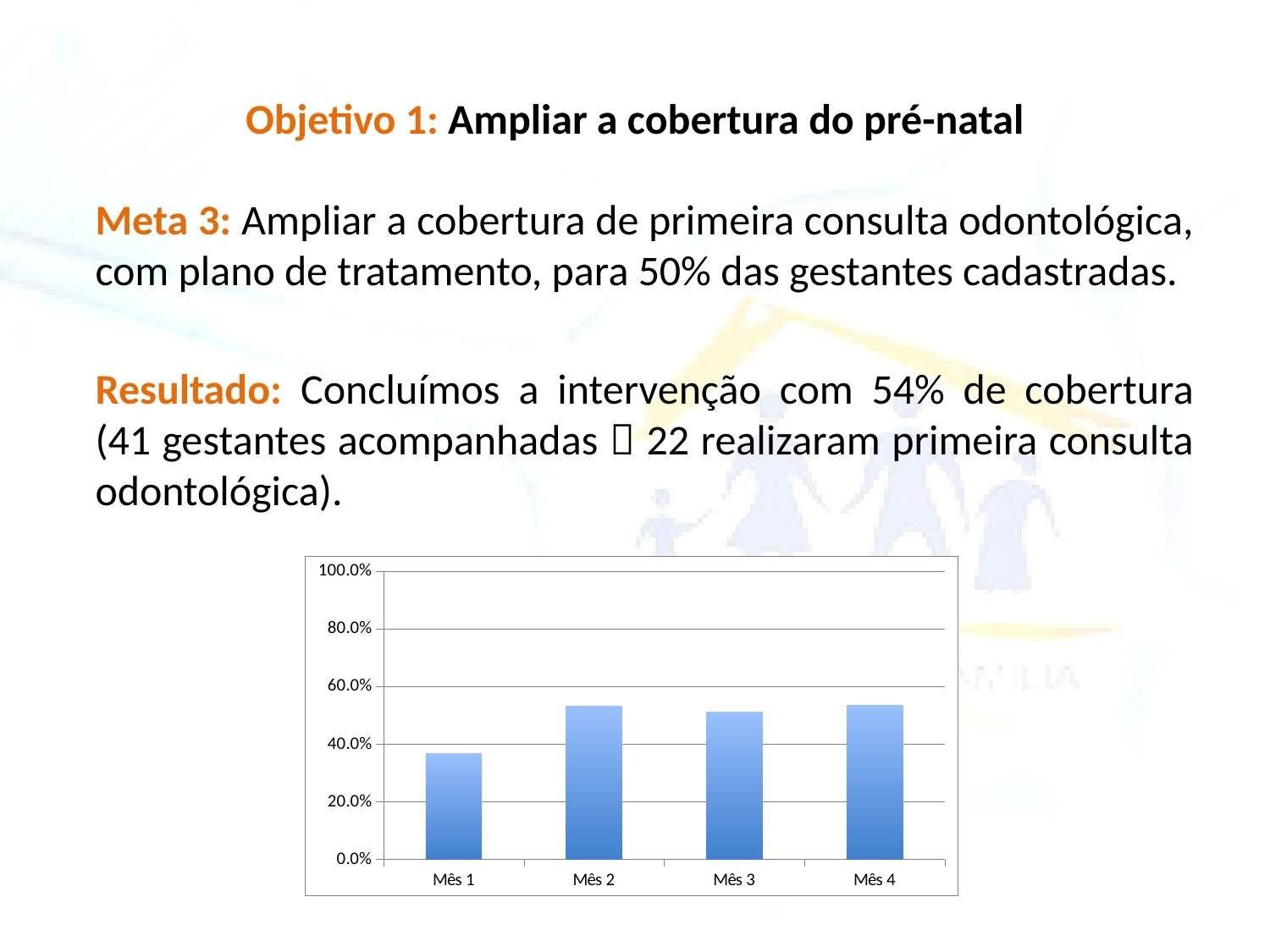
Is the value for Mês 3 greater or less than 40.0%? greater What kind of chart is shown on the slide? bar chart Is the value for Mês 1 greater or less than 20.0%? greater Does the value rise or fall from Mês 1 to Mês 2? rise Which is larger, the value for Mês 1 or the value for Mês 2? Mês 2 Is the value for Mês 1 greater or less than 40.0%? less Which is larger, the value for Mês 3 or the value for Mês 1? Mês 3 Which month has the lowest bar in the chart? Mês 1 What is the highest tick value shown on the y axis of the chart? 100.0% How many categories (months) are shown on the x axis of the chart? 4